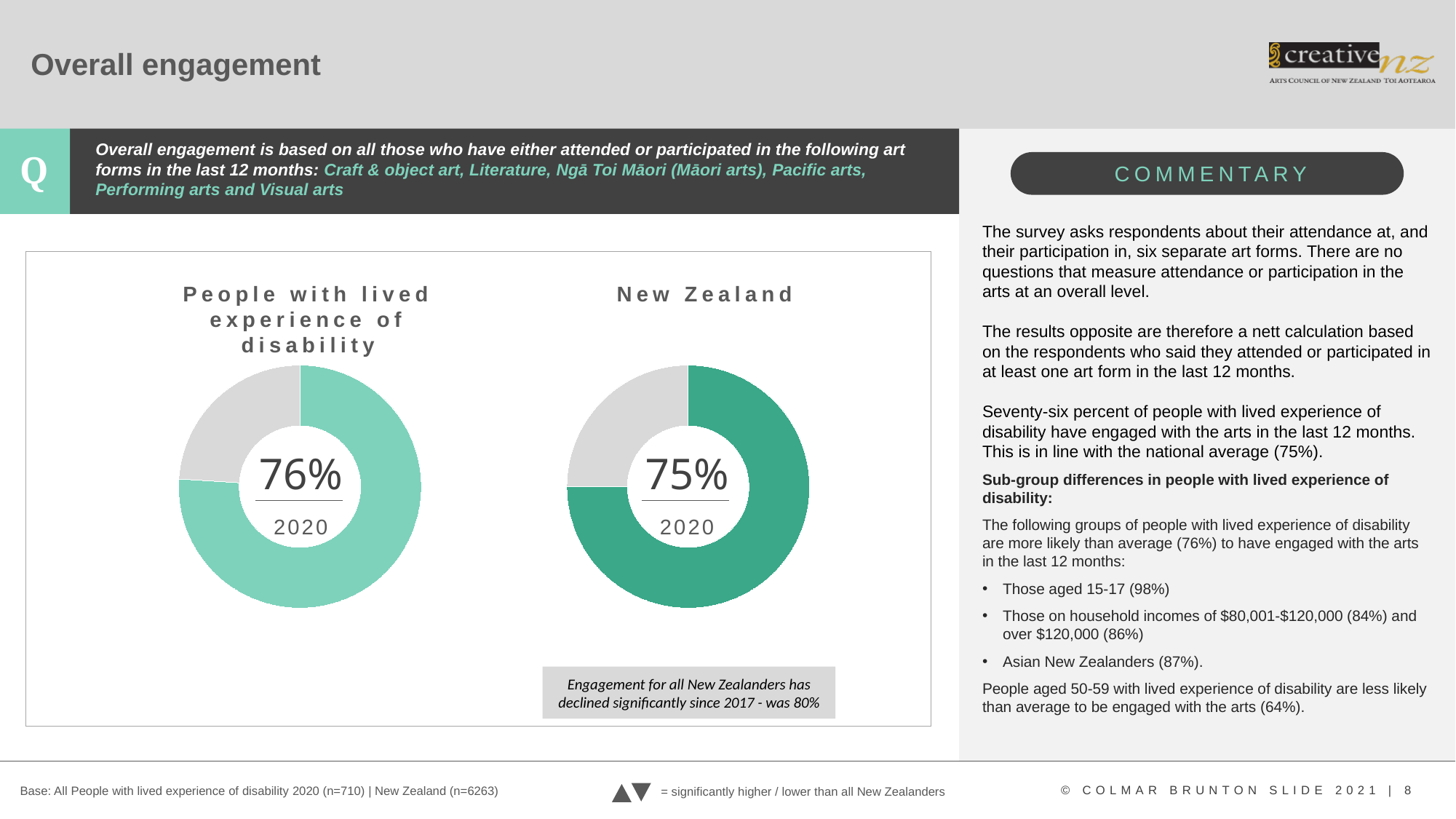
In the 'People with lived experience of disability' chart, what share of the donut is not coloured (the grey remainder)? 24% Has engagement for all New Zealanders risen or declined since 2017 according to the chart note? declined In the 'New Zealand' chart, is the engagement value greater or less than 50%? greater What is the difference between the engagement value for people with lived experience of disability and the value for New Zealand? 1 percentage point What is the title of the left-hand donut chart? People with lived experience of disability Which chart shows the higher engagement value, 'People with lived experience of disability' or 'New Zealand'? People with lived experience of disability How many donut charts are shown on the slide? 2 What type of chart is used to show overall engagement for people with lived experience of disability? Donut (pie) chart In the 'People with lived experience of disability' chart, what percentage is shown in the centre of the donut? 76% According to the note under the 'New Zealand' chart, what was engagement for all New Zealanders in 2017? 80% What year is labelled beneath the percentage in the 'New Zealand' donut chart? 2020 In the 'New Zealand' chart, what percentage is shown in the centre of the donut? 75%